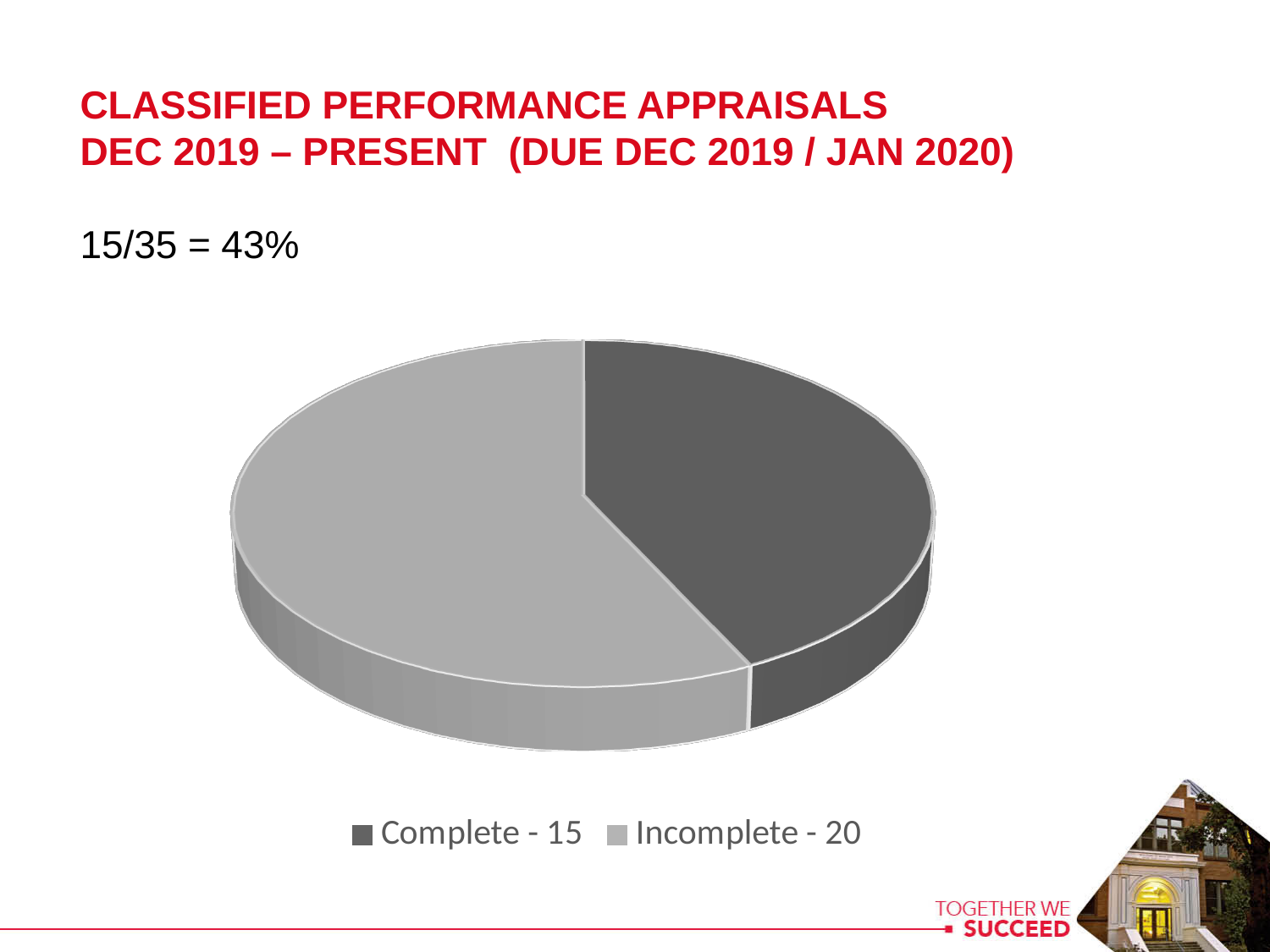
What is the difference between the Incomplete and Complete values? 5 What is the value for Incomplete? 20 What is the value for Complete? 15 Which category has the smallest slice? Complete Which is larger, Complete or Incomplete? Incomplete What share of the pie does Complete represent, as stated on the slide? 43% Which category has the largest slice? Incomplete What kind of chart is shown on the slide? Pie chart How many slices does the pie chart have? 2 How many entries does the legend list? 2 Which slice is shown in the darker gray colour? Complete - 15 What is the total of the two slices? 35